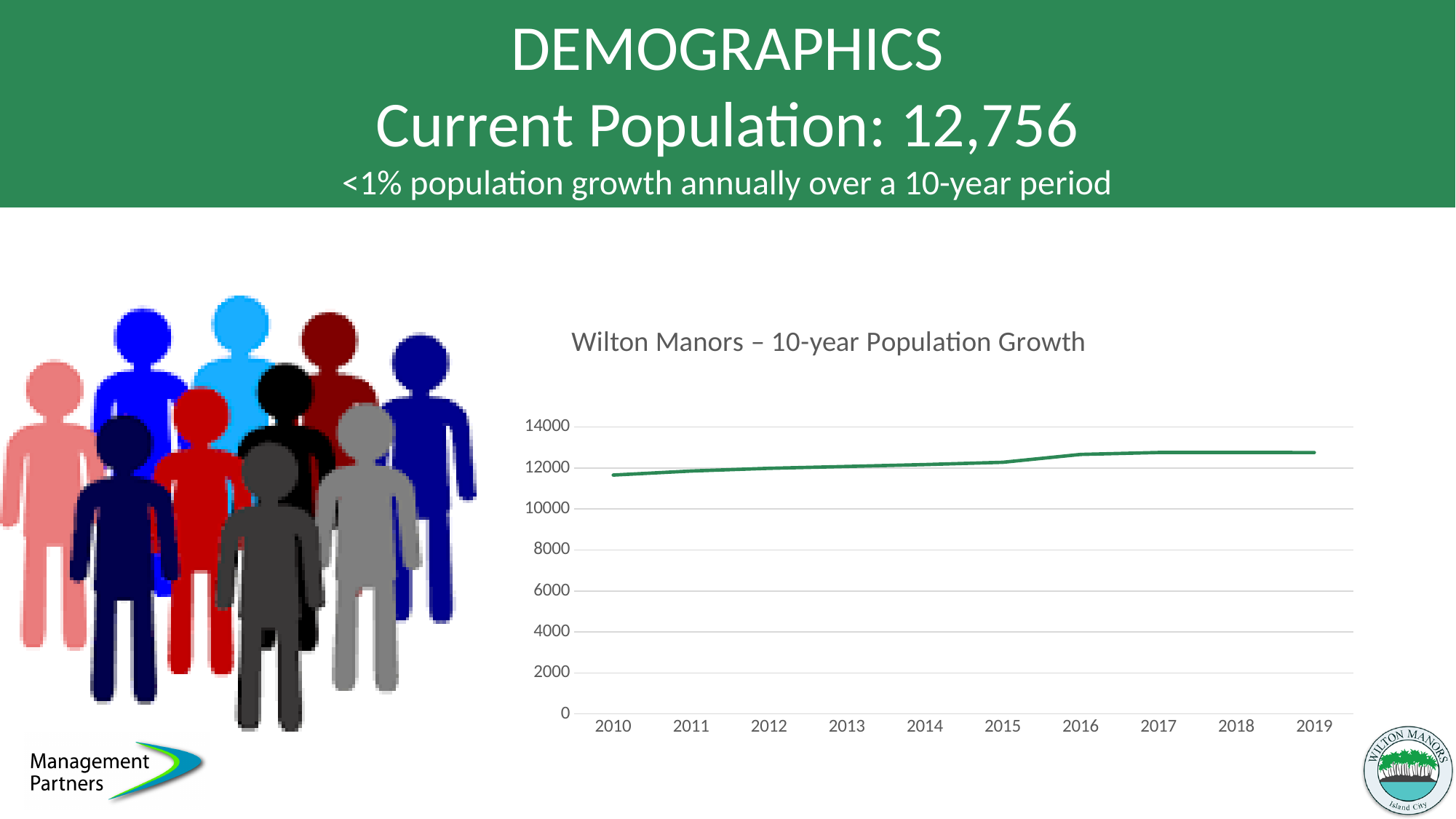
Which year has the larger value, 2015 or 2019? 2019 How many years are plotted along the x axis of the chart? 10 Is the value for 2016 greater or less than 14000? less What kind of chart is shown on the slide? line chart Does the population line rise or fall from 2010 to 2019? rise Is the value for 2019 greater or less than 12000? greater What is the first year shown on the x axis of the chart? 2010 What is the title of the chart? Wilton Manors – 10-year Population Growth Is the value for 2013 greater or less than 10000? greater Which year has the larger value, 2010 or 2016? 2016